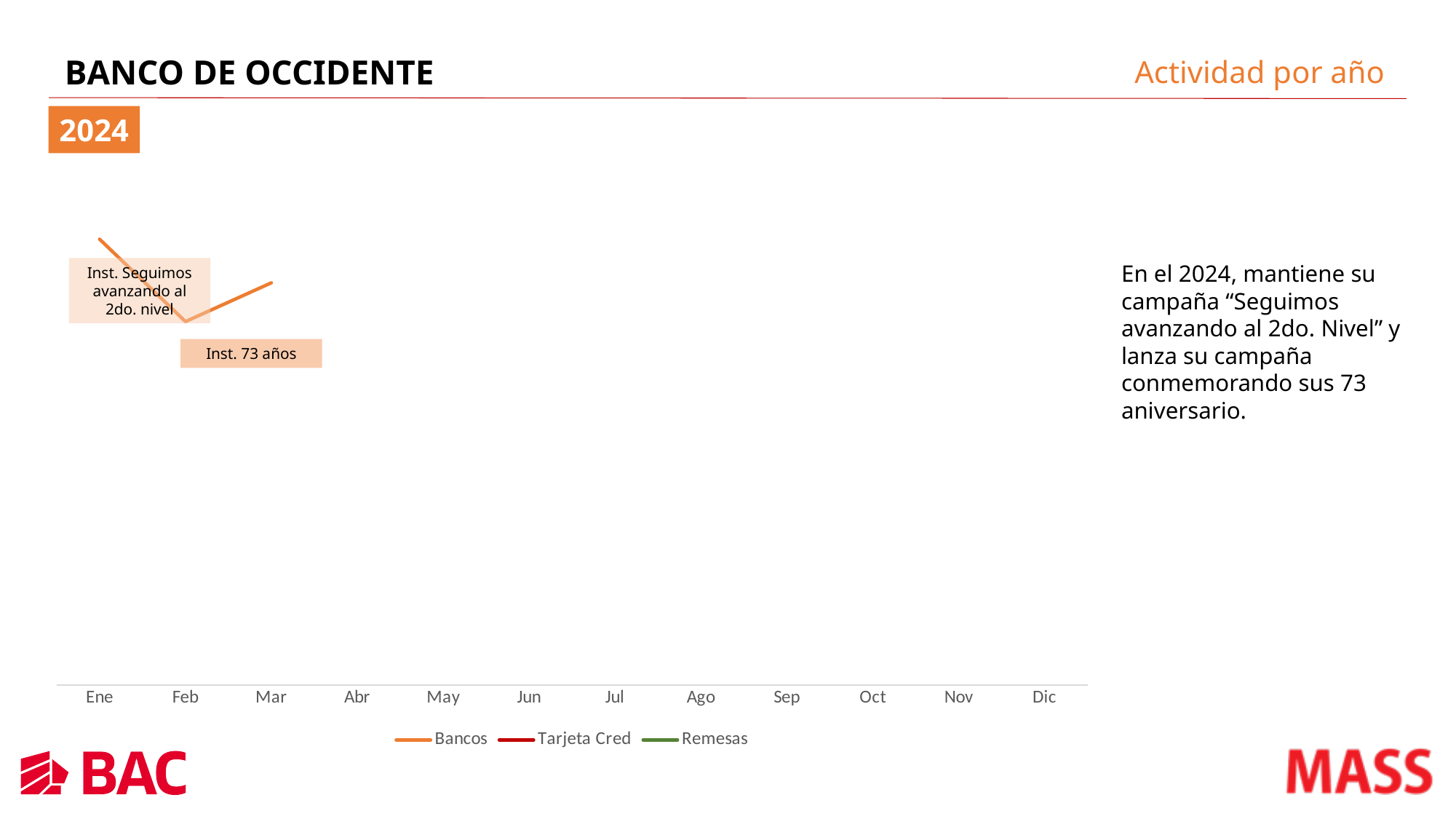
What is the last month labelled on the x axis of the chart? Dic How many months are labelled along the x axis of the chart? 12 Which series are listed in the chart legend? Bancos, Tarjeta Cred, Remesas Does the Bancos line rise or fall from Ene to Feb? falls What kind of chart is shown on the slide? line chart Among the plotted months, in which month is the Bancos line at its highest point? Ene How many series does the chart legend list? 3 Does the Bancos line rise or fall from Feb to Mar? rises For the Bancos series, is the value in Mar or in Feb larger? Mar For the Bancos series, is the value in Ene or in Feb larger? Ene Which series is the only one with a visible line plotted on the chart? Bancos Among the plotted months, in which month is the Bancos line at its lowest point? Feb